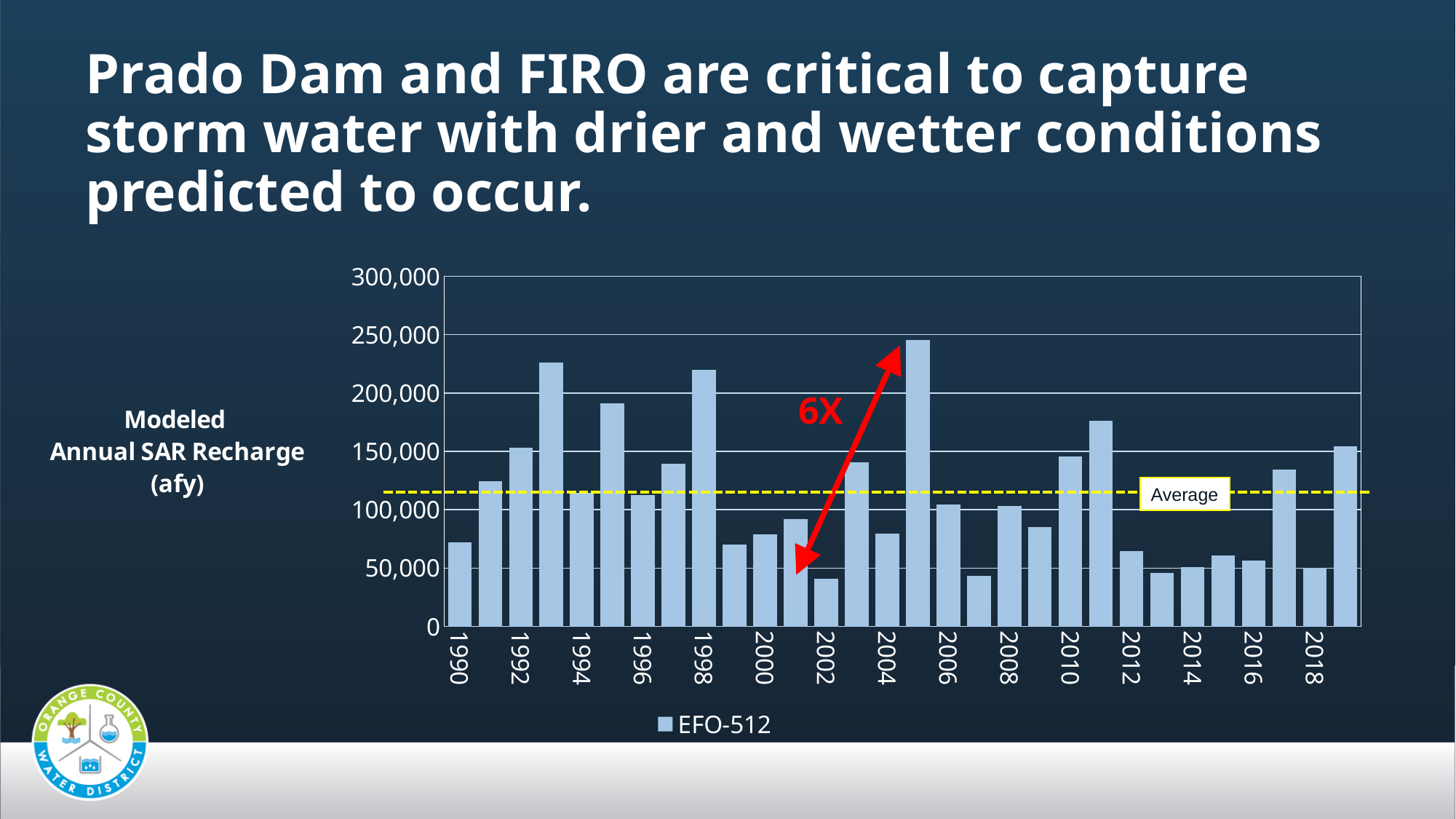
Which year has the larger value, 1995 or 2011? 1995 What is the name of the series shown in the legend? EFO-512 Is the value for 2002 greater or less than 50,000? less What does the dashed yellow horizontal line represent? Average Is the value for 1993 greater or less than 200,000? greater How many series does the legend list? 1 Is the value for 2011 greater or less than 150,000? greater What kind of chart is shown on the slide? bar chart Which year has the larger value, 2002 or 2004? 2004 Which year has the highest modeled annual SAR recharge? 2005